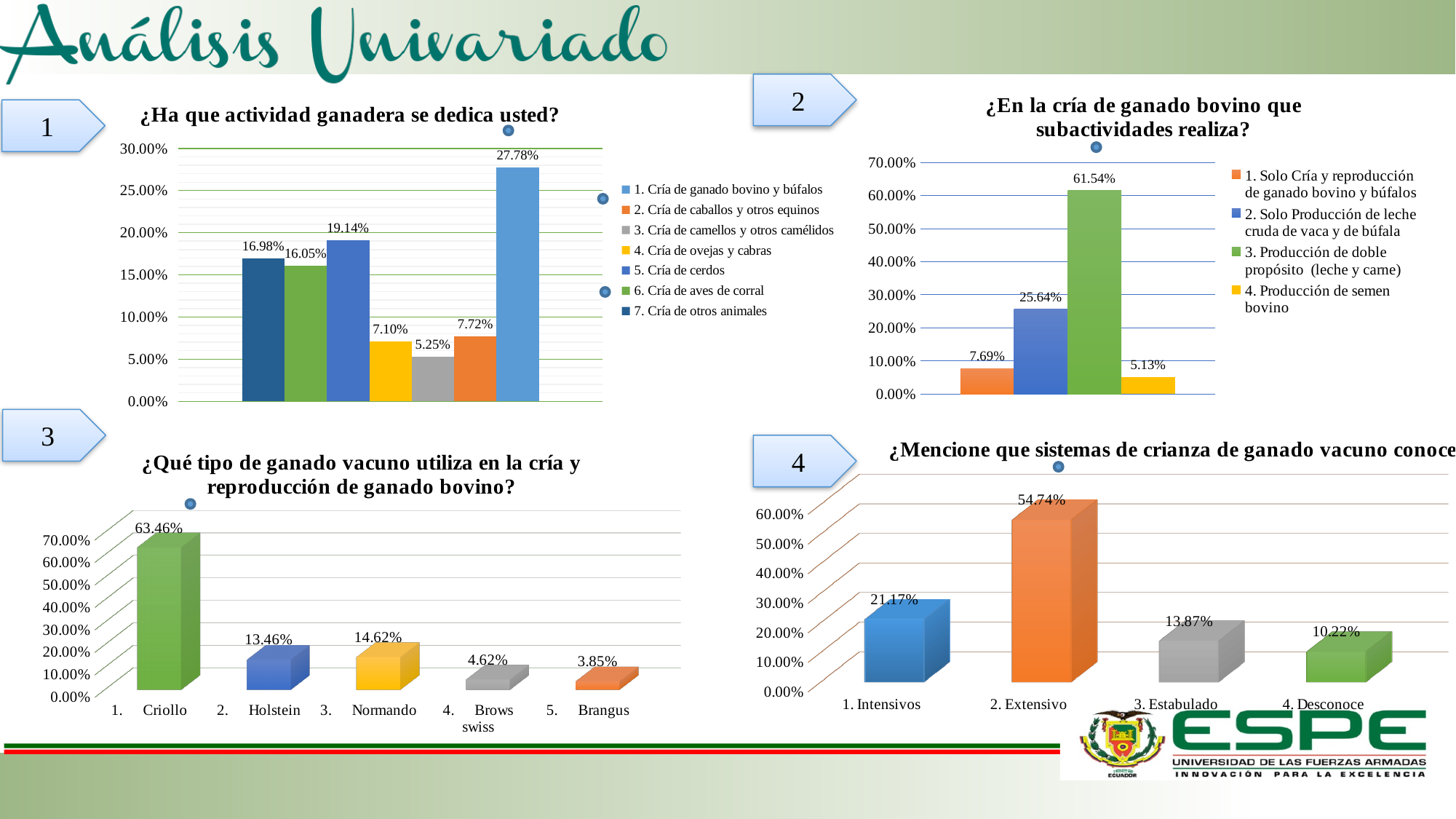
In the chart '¿Ha que actividad ganadera se dedica usted?', which category has the lowest value? 3. Cría de camellos y otros camélidos How many entries does the legend list in the chart '¿Ha que actividad ganadera se dedica usted?'? 7 What kind of chart is the bottom-right chart '¿Mencione que sistemas de crianza de ganado vacuno conoce'? Bar chart In the chart '¿Mencione que sistemas de crianza de ganado vacuno conoce', what is the value for '2. Extensivo'? 54.74% How many categories are shown in the chart '¿Qué tipo de ganado vacuno utiliza en la cría y reproducción de ganado bovino?'? 5 In the chart '¿Qué tipo de ganado vacuno utiliza en la cría y reproducción de ganado bovino?', which is larger, Normando or Holstein? Normando In the chart '¿En la cría de ganado bovino que subactividades realiza?', what is the value for '2. Solo Producción de leche cruda de vaca y de búfala'? 25.64% In the chart '¿Qué tipo de ganado vacuno utiliza en la cría y reproducción de ganado bovino?', what is the value for Holstein? 13.46% In the chart '¿En la cría de ganado bovino que subactividades realiza?', what is the difference between '1. Solo Cría y reproducción de ganado bovino y búfalos' and '4. Producción de semen bovino'? 2.56% In the chart '¿En la cría de ganado bovino que subactividades realiza?', which category has the highest value? 3. Producción de doble propósito (leche y carne) In the chart '¿Mencione que sistemas de crianza de ganado vacuno conoce', what is the difference between '1. Intensivos' and '3. Estabulado'? 7.30% In the chart '¿Ha que actividad ganadera se dedica usted?', what is the value for '1. Cría de ganado bovino y búfalos'? 27.78%